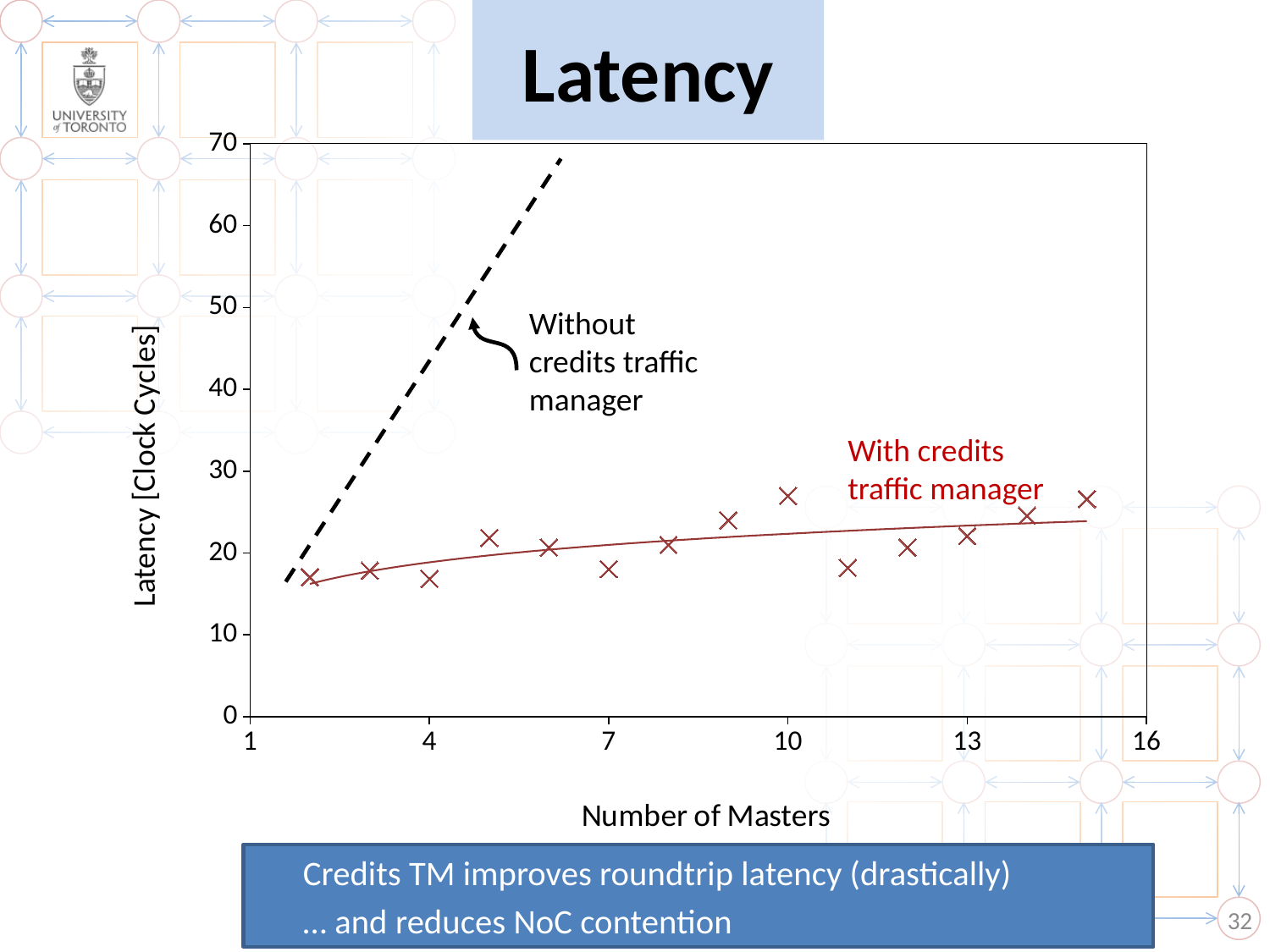
Is the 'With credits traffic manager' latency at 10 masters greater or less than 20 clock cycles? greater Does the 'Without credits traffic manager' latency rise or fall as the number of masters increases? rise What is the highest value shown on the y axis? 70 At 4 masters, which series has the higher latency: 'Without credits traffic manager' or 'With credits traffic manager'? Without credits traffic manager What is the label of the y axis? Latency [Clock Cycles] Is the 'With credits traffic manager' latency at 10 masters greater or less than 30 clock cycles? less Does the fitted line for 'With credits traffic manager' rise or fall as the number of masters increases? rise What is the title of the chart? Latency How many data points (x markers) are plotted for the 'With credits traffic manager' series? 14 Is the 'With credits traffic manager' latency at 2 masters greater or less than 20 clock cycles? less What kind of chart is shown on the slide? scatter chart